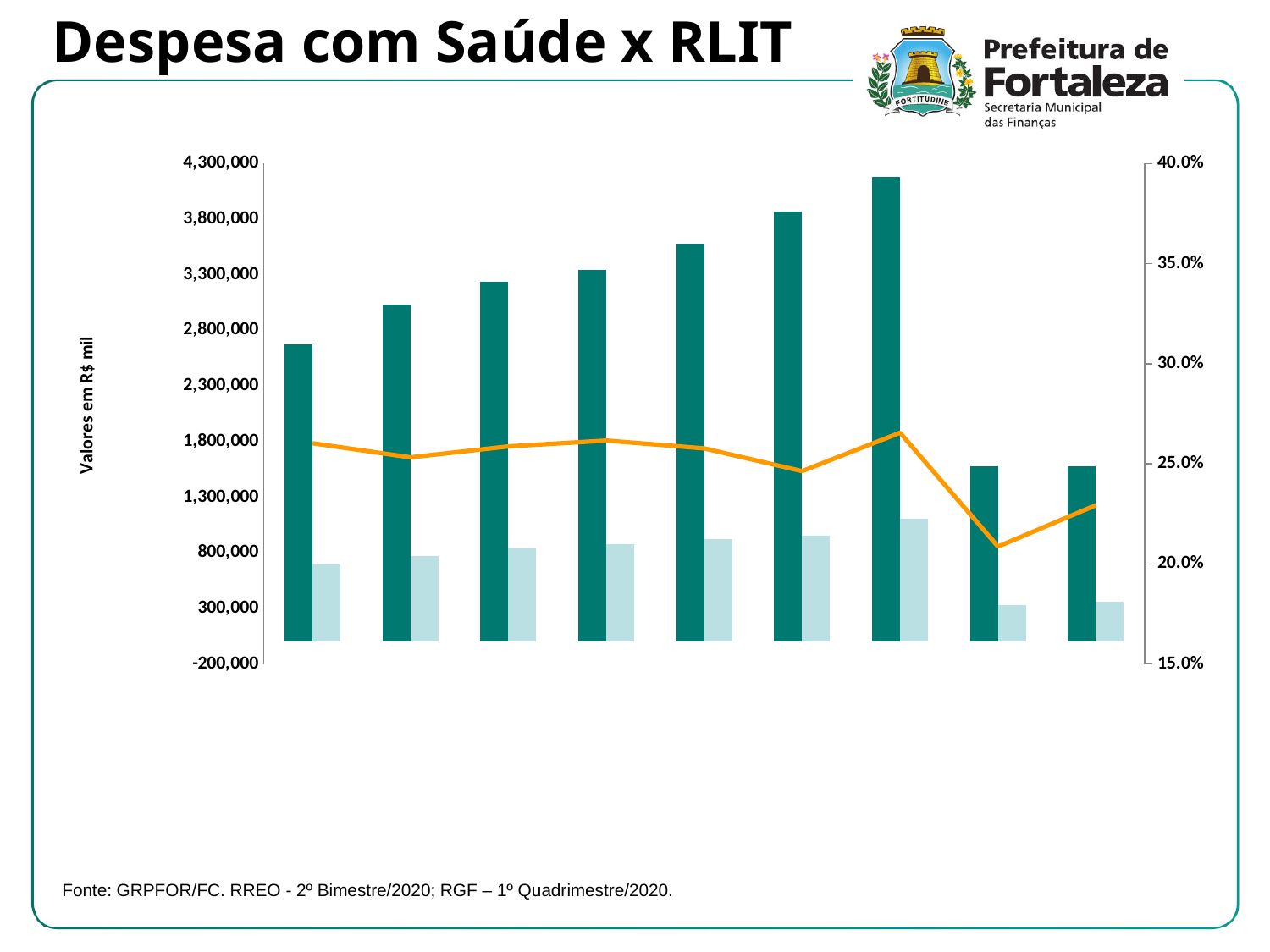
Is the first dark green bar from the left greater or less than 2,800,000? less Is the tallest light blue bar greater or less than 1,300,000? less What kind of chart is shown on the slide? Bar chart combined with a line Is the tallest dark green bar greater or less than 3,800,000? greater How many groups of bars are plotted along the x axis? 9 Which group, counting from the left, has the tallest dark green bar? The seventh How many data series are plotted on the chart? 3 What is the label of the left vertical axis? Valores em R$ mil Do the dark green bars rise or fall from the first group to the seventh group? rise What is the title of the chart on the slide? Despesa com Saúde x RLIT